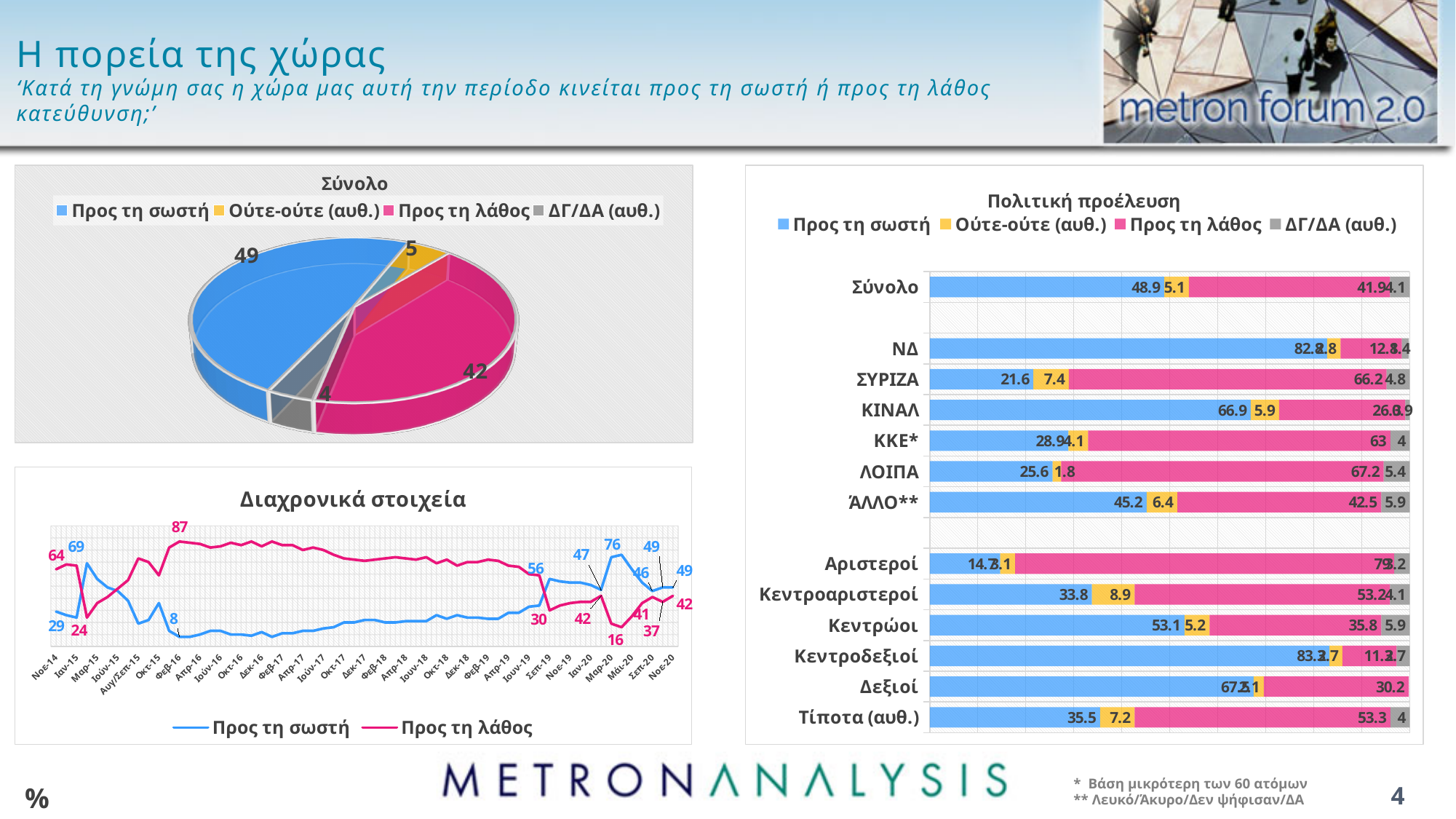
In the line chart titled Διαχρονικά στοιχεία, what is the highest labelled value of the Προς τη λάθος series? 87 What kind of chart is the one titled Πολιτική προέλευση? stacked bar chart In the pie chart titled Σύνολο, which category has the smallest slice? ΔΓ/ΔΑ (αυθ.) In the pie chart titled Σύνολο, how many categories does the legend list? 4 In the line chart titled Διαχρονικά στοιχεία, what is the difference between the Προς τη σωστή and Προς τη λάθος values at Νοε-14? 35 In the chart titled Πολιτική προέλευση, which is larger for Κεντρώοι: Προς τη σωστή or Προς τη λάθος? Προς τη σωστή In the chart titled Πολιτική προέλευση, what is the Προς τη σωστή value for ΣΥΡΙΖΑ? 21.6 In the pie chart titled Σύνολο, what is the value for Προς τη σωστή? 49 In the line chart titled Διαχρονικά στοιχεία, how many series does the legend list? 2 In the chart titled Πολιτική προέλευση, what is the Προς τη λάθος value for ΛΟΙΠΑ? 67.2 In the pie chart titled Σύνολο, what is the value for Προς τη λάθος? 42 In the line chart titled Διαχρονικά στοιχεία, what is the value of Προς τη σωστή at Νοε-20? 49